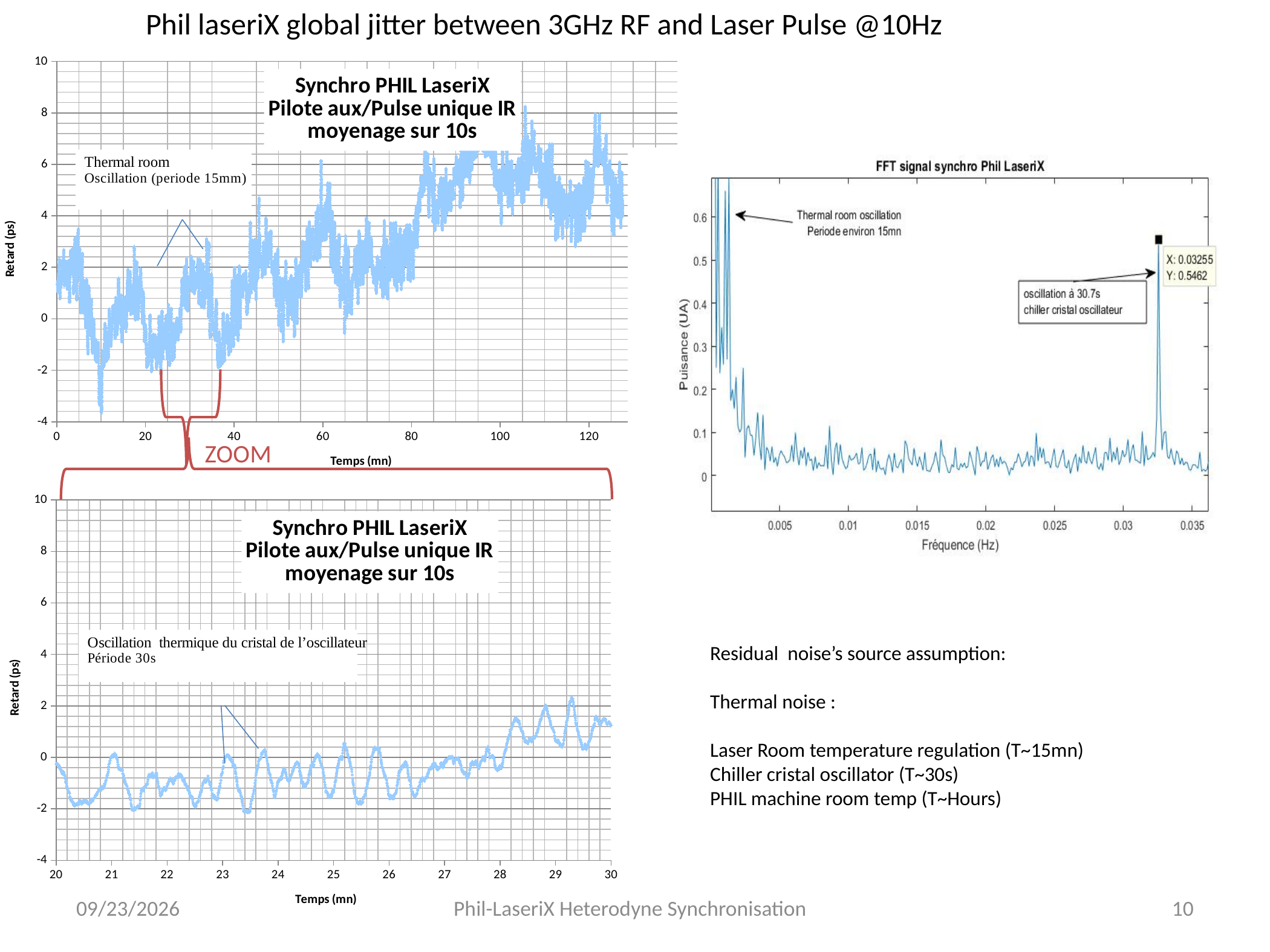
In the top-left chart, does the signal overall rise or fall from 0 to 120 mn? rise In the top-left chart, is the value at around 100 mn greater or less than 2? greater In the FFT chart on the right, what is the X value shown at the marked peak? 0.03255 What kind of chart is the top-left chart titled 'Synchro PHIL LaseriX Pilote aux/Pulse unique IR moyenage sur 10s'? line chart In the bottom-left zoom chart, what is the lowest value shown on the x axis? 20 In the top-left chart, what is the label of the x axis? Temps (mn) In the bottom-left zoom chart, is the value at around 29 mn greater or less than 0? greater In the bottom-left zoom chart, what period is given for the thermal oscillation of the oscillator crystal? 30s In the top-left chart, what is the label of the y axis? Retard (ps) In the FFT chart on the right, is the value at 0.02 Hz greater or less than 0.1? less In the FFT chart on the right, what is the Y value shown at the marked peak? 0.5462 In the bottom-left zoom chart, what is the highest value shown on the x axis? 30